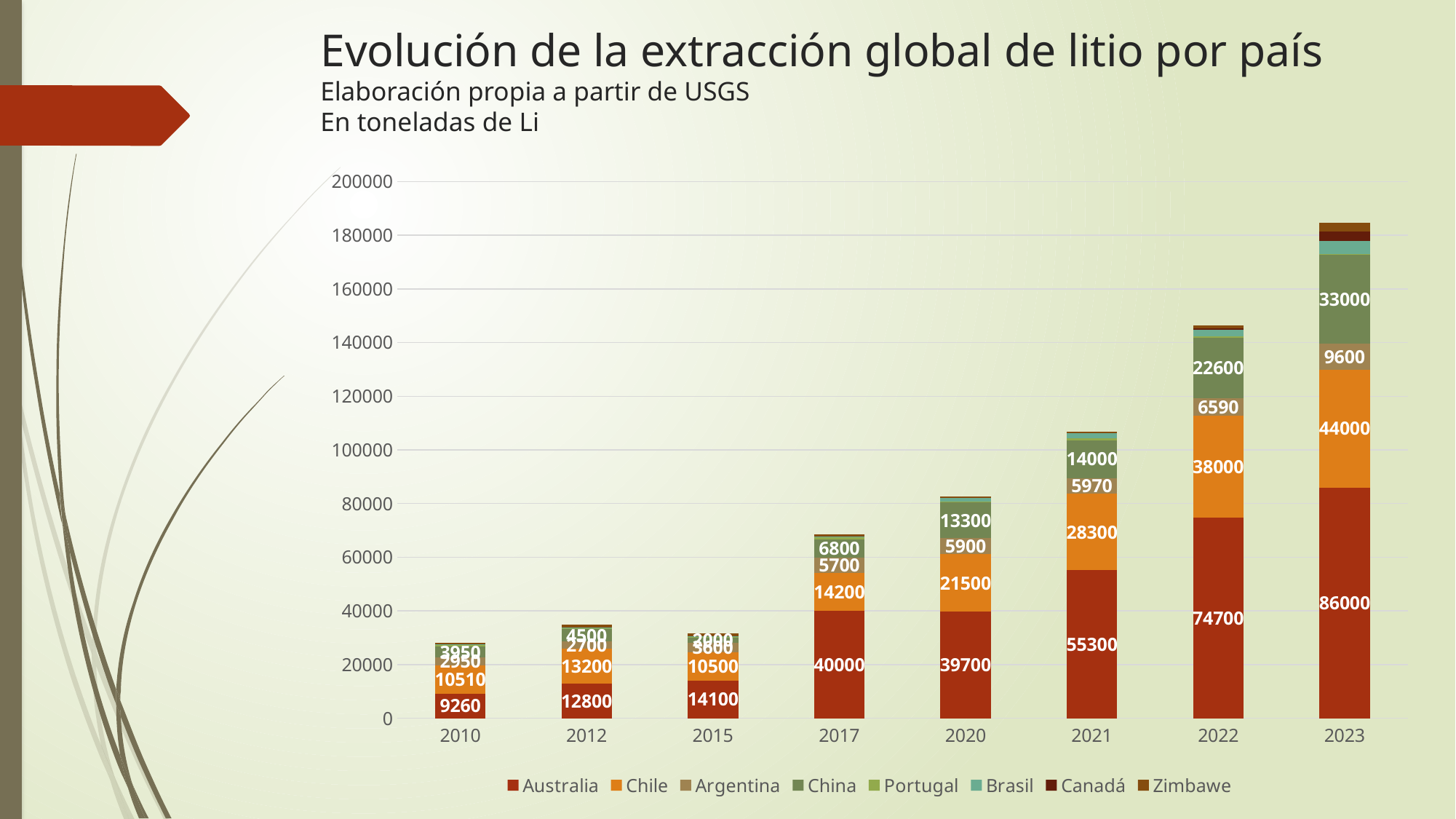
Does the value for Chile rise or fall from 2015 to 2023? rise What is the value for China in 2020? 13300 Is the total height of the 2023 stacked bar greater or less than 180000? greater How many years are shown on the x axis? 8 What is the value for Australia in 2023? 86000 What kind of chart is shown on the slide? stacked bar chart What is the value for Chile in 2022? 38000 In which year is the Australia segment the largest? 2023 In 2017, which is larger: the value for Chile or the value for China? Chile What is the value for Argentina in 2021? 5970 How many series does the legend list? 8 What is the difference between the Australia values for 2023 and 2022? 11300